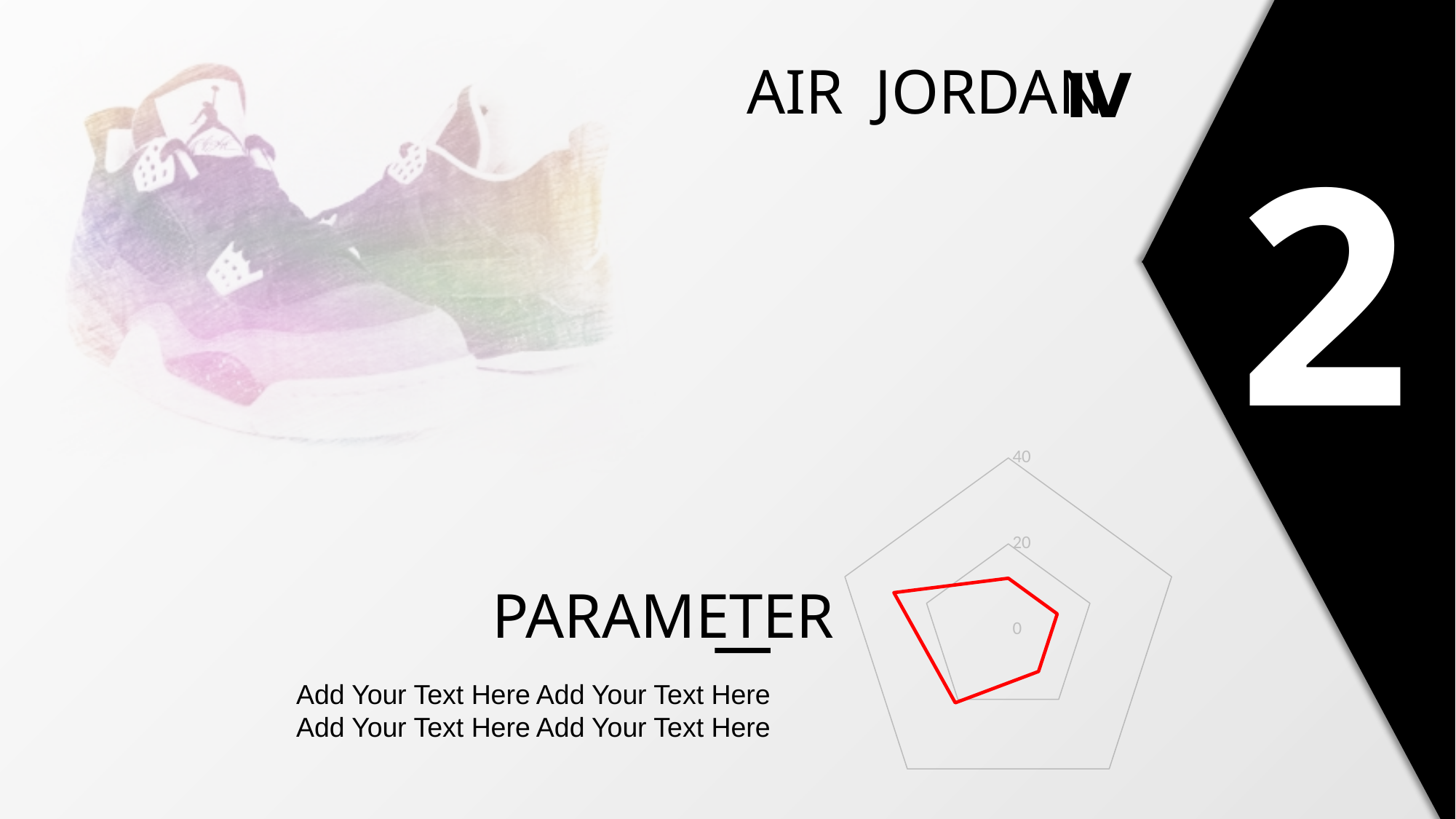
What colour is the data series line on the radar chart? red How many data series are plotted on the radar chart? 1 What kind of chart is shown on the slide? radar chart Is the value on the upper-left axis of the radar chart greater or less than 20? greater How many axes (data points) does the radar chart have? 5 Is the value on the upper-left axis of the radar chart greater or less than 40? less What is the highest tick value shown on the radar chart's axis? 40 Which axis of the radar chart has the highest value? the upper-left axis Is the value on the upper-right axis of the radar chart greater or less than 20? less Which is larger on the radar chart: the value on the upper-left axis or the value on the top axis? the upper-left axis